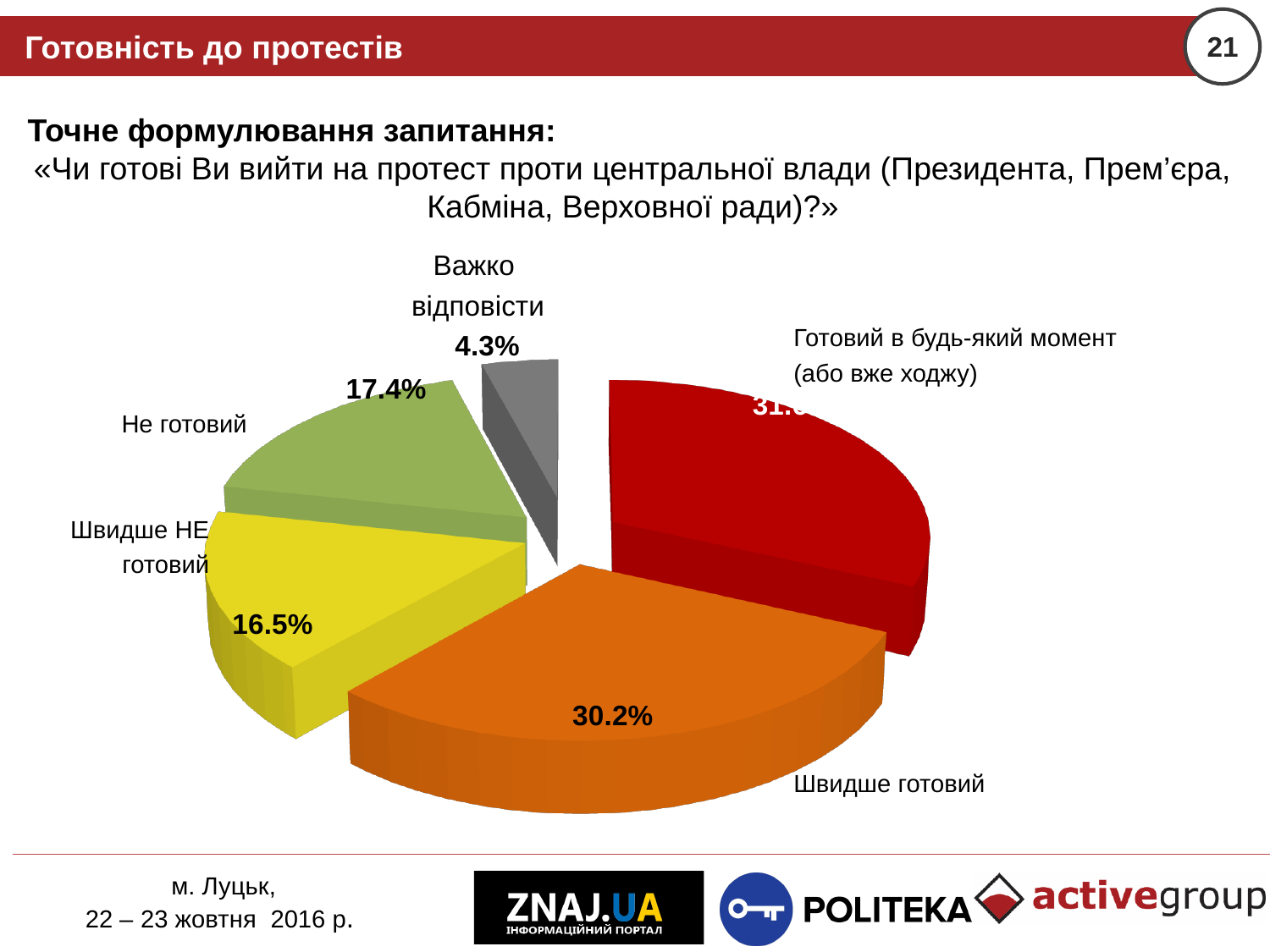
What percentage of respondents answered "Швидше НЕ готовий"? 16.5% What percentage of respondents answered "Швидше готовий"? 30.2% What percentage of respondents answered "Важко відповісти"? 4.3% What is the difference in percentage points between "Швидше готовий" and "Швидше НЕ готовий"? 13.7 What percentage of respondents answered "Не готовий"? 17.4% What type of chart is shown on the slide? Pie chart How many answer categories are shown in the pie chart? 5 Which answer category has the smallest share of the pie? Важко відповісти What is the difference in percentage points between "Не готовий" and "Важко відповісти"? 13.1 What colour is the slice for "Швидше готовий"? Orange Which is larger: the share for "Швидше готовий" or the share for "Не готовий"? Швидше готовий Which is larger: the share for "Не готовий" or the share for "Швидше НЕ готовий"? Не готовий